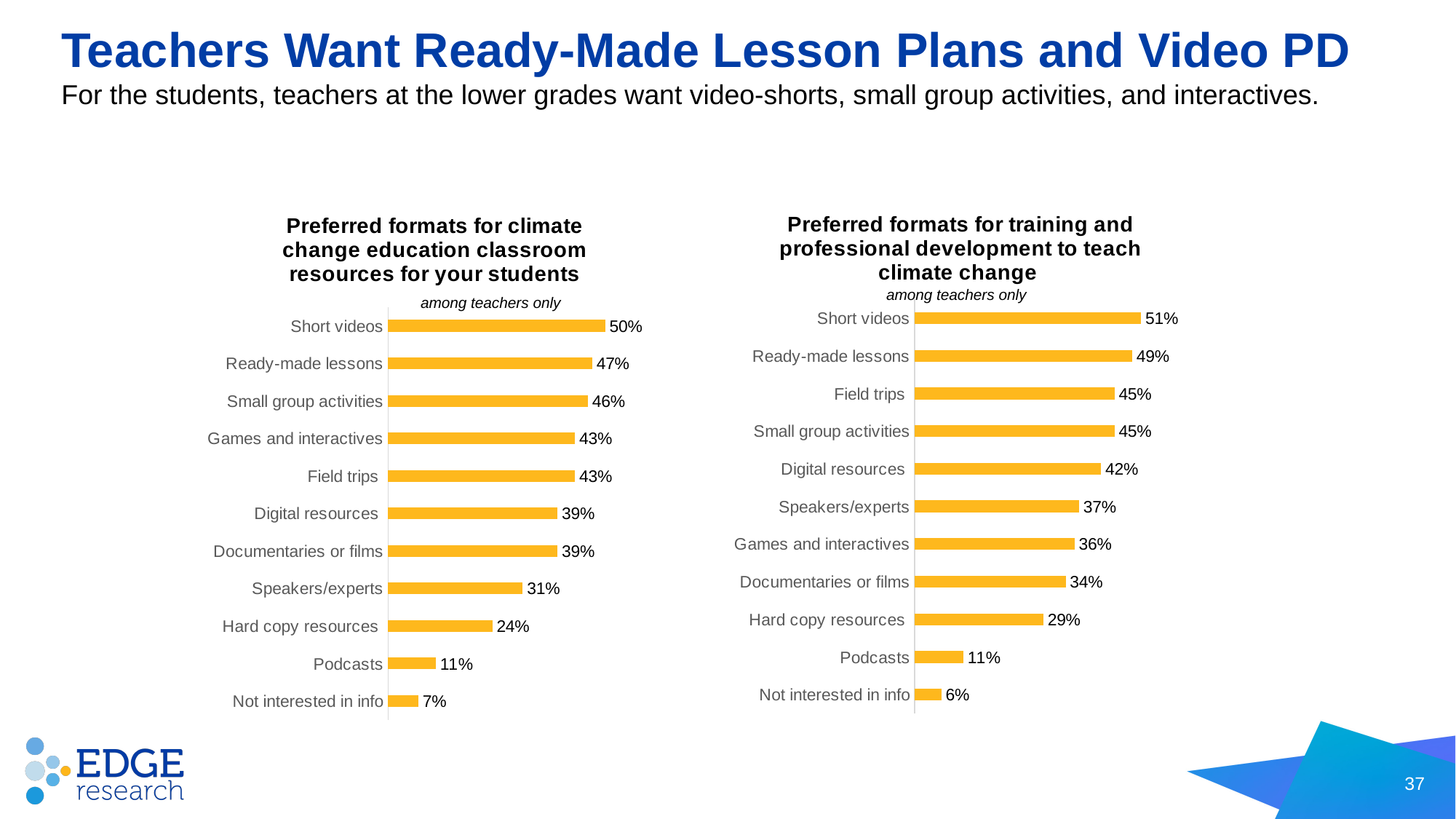
What kind of chart is the right chart (training and professional development)? Bar chart In the left chart (classroom resources for your students), what is the difference between Speakers/experts and Podcasts? 20 percentage points In the left chart (Preferred formats for climate change education classroom resources for your students), what is the value for Ready-made lessons? 47% In the right chart (Preferred formats for training and professional development to teach climate change), what is the value for Speakers/experts? 37% In the right chart (training and professional development), which is larger: Digital resources or Documentaries or films? Digital resources What note appears in italics under the title of each chart? among teachers only In the left chart (classroom resources for your students), what is the value for Hard copy resources? 24% How many categories are shown in the left chart (classroom resources for your students)? 11 In the right chart (training and professional development), what is the difference between Short videos and Hard copy resources? 22 percentage points In the right chart (training and professional development), which category has the lowest value? Not interested in info Which is larger: Games and interactives in the left chart (classroom resources) or Games and interactives in the right chart (training and professional development)? Left chart (classroom resources), 43% In the left chart (classroom resources for your students), which category has the highest value? Short videos